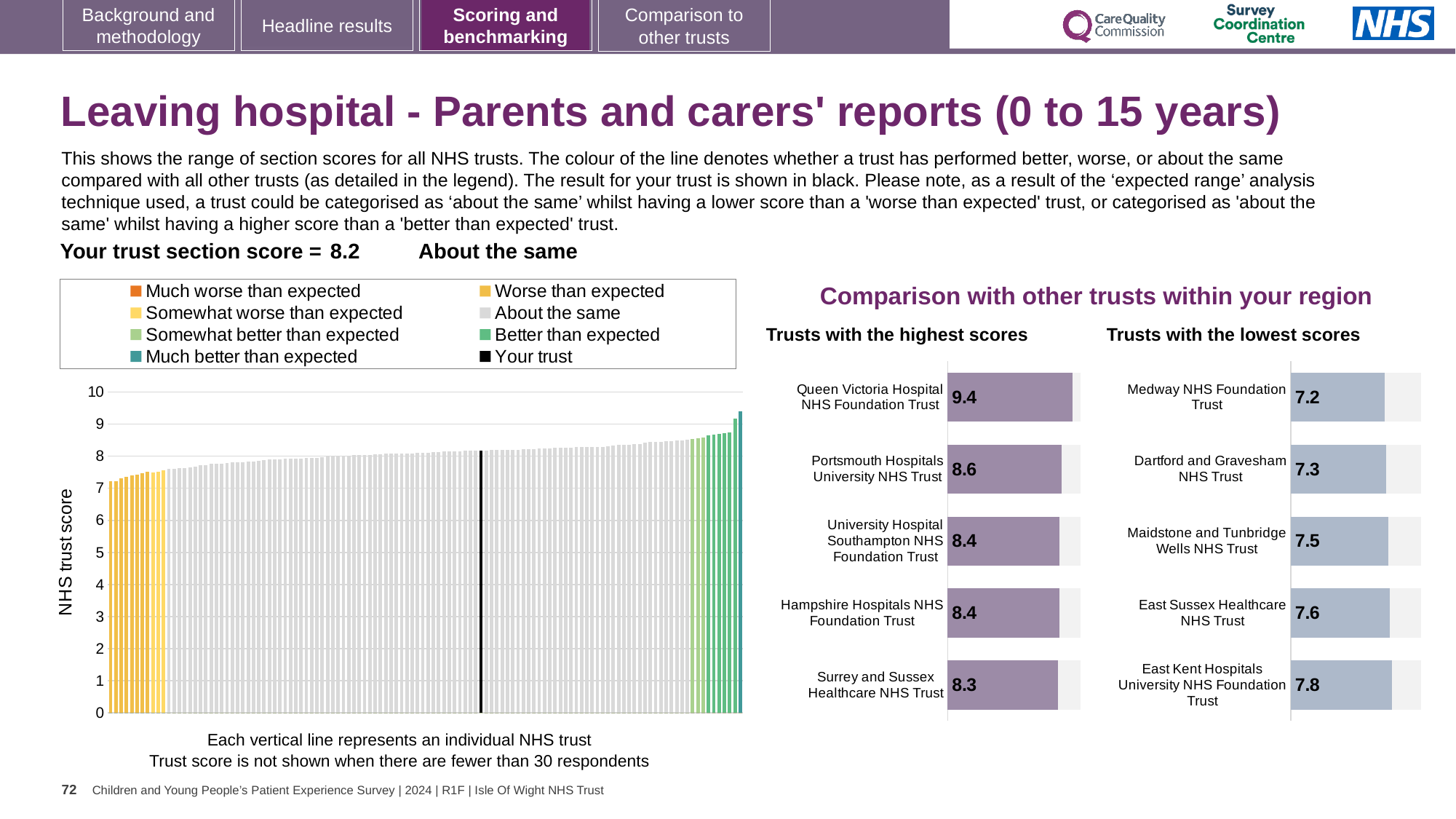
In the 'Trusts with the highest scores' chart, what is the score for Queen Victoria Hospital NHS Foundation Trust? 9.4 In the 'Trusts with the highest scores' chart, which trust has the highest score? Queen Victoria Hospital NHS Foundation Trust In the 'Trusts with the lowest scores' chart, which trust has the lowest score? Medway NHS Foundation Trust How many entries does the legend of the NHS trust score chart on the left list? 8 In the 'Trusts with the highest scores' chart, what is the difference between the scores of Queen Victoria Hospital NHS Foundation Trust and Surrey and Sussex Healthcare NHS Trust? 1.1 In the 'Trusts with the highest scores' chart, what is the score for Portsmouth Hospitals University NHS Trust? 8.6 How many trusts are shown in the 'Trusts with the lowest scores' chart? 5 In the NHS trust score chart on the left, do the bars rise or fall from left to right? Rise What kind of chart is the NHS trust score chart on the left of the slide? Bar chart In the 'Trusts with the lowest scores' chart, what is the score for Medway NHS Foundation Trust? 7.2 In the 'Trusts with the lowest scores' chart, what is the score for East Kent Hospitals University NHS Foundation Trust? 7.8 In the 'Trusts with the lowest scores' chart, which has the larger score: Dartford and Gravesham NHS Trust or East Sussex Healthcare NHS Trust? East Sussex Healthcare NHS Trust